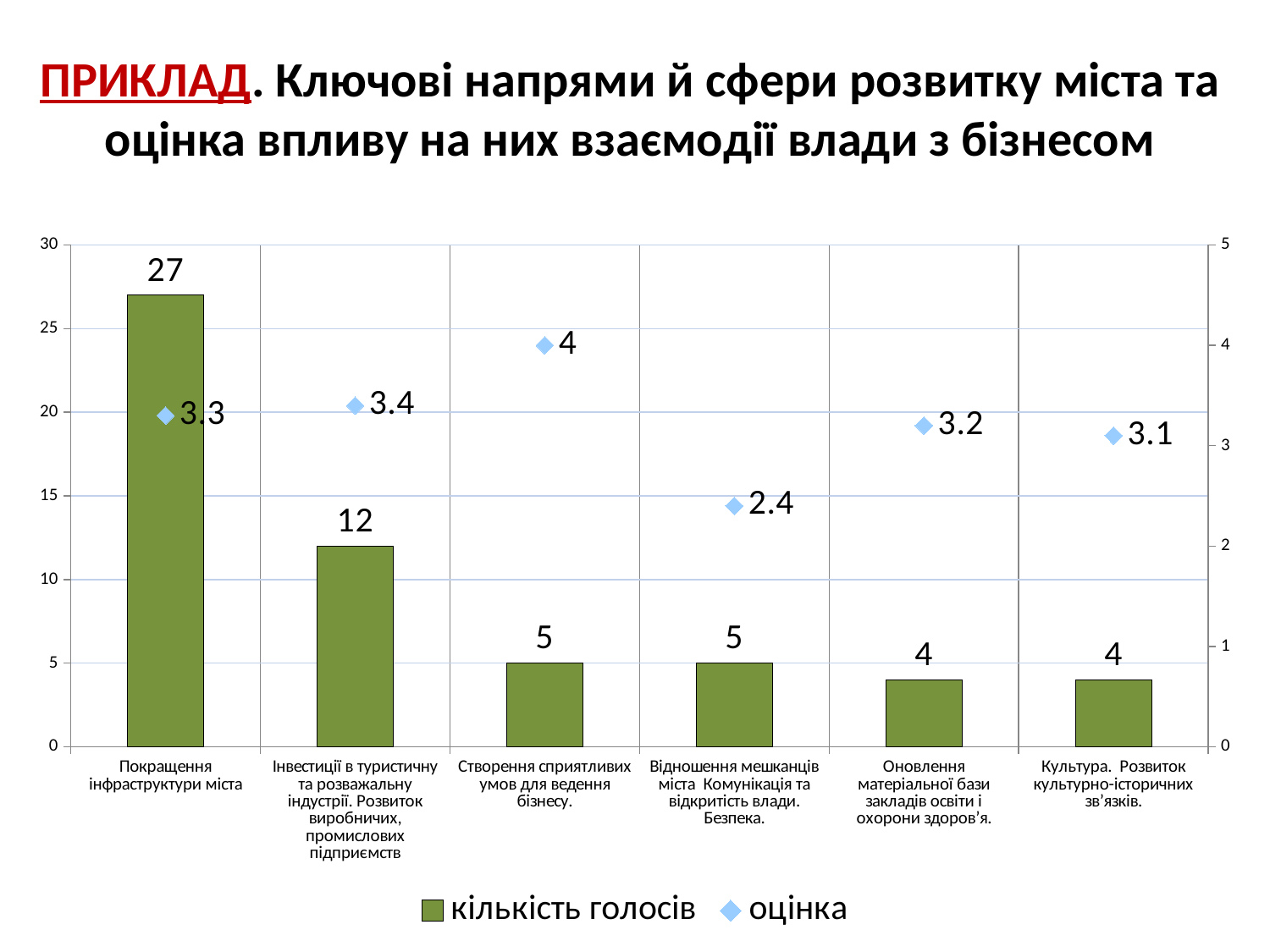
How many votes (кількість голосів) does the category "Покращення інфраструктури міста" have? 27 What is the оцінка (score) for "Створення сприятливих умов для ведення бізнесу"? 4 How many categories are shown on the x axis of the chart? 6 What kind of chart is used to show кількість голосів? bar chart Which has a higher оцінка: "Оновлення матеріальної бази закладів освіти і охорони здоров'я" or "Культура. Розвиток культурно-історичних зв'язків"? Оновлення матеріальної бази закладів освіти і охорони здоров'я Which category has the lowest оцінка (score)? Відношення мешканців міста. Комунікація та відкритість влади. Безпека How many series does the legend list? 2 What is the difference in votes between "Покращення інфраструктури міста" and "Інвестиції в туристичну та розважальну індустрії"? 15 What are the two series named in the legend? кількість голосів and оцінка Which category has the highest number of votes (кількість голосів)? Покращення інфраструктури міста What is the оцінка (score) for "Відношення мешканців міста. Комунікація та відкритість влади. Безпека"? 2.4 What is the total number of votes across all six categories? 57